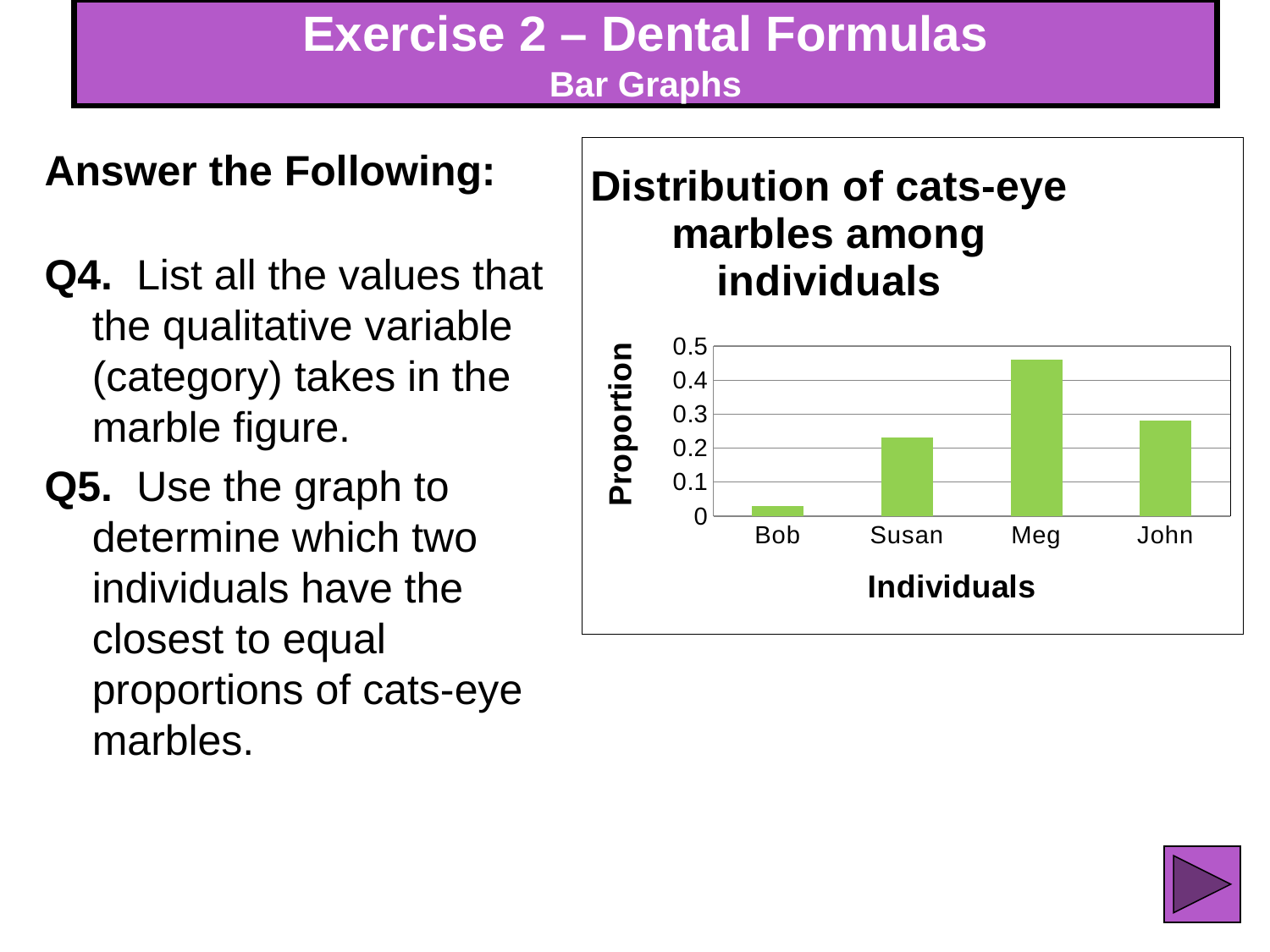
Who has a larger proportion of cats-eye marbles, John or Bob? John Who has a larger proportion of cats-eye marbles, Meg or Susan? Meg Is the proportion for John greater or less than 0.2? greater What kind of chart is shown on the slide? bar chart How many individuals are shown on the x axis of the chart? 4 Which individual has the lowest proportion of cats-eye marbles? Bob Is the proportion for Meg greater or less than 0.4? greater Is the proportion for Bob greater or less than 0.1? less Which individual has the highest proportion of cats-eye marbles? Meg What is the label of the vertical axis of the chart? Proportion What is the title of the chart? Distribution of cats-eye marbles among individuals